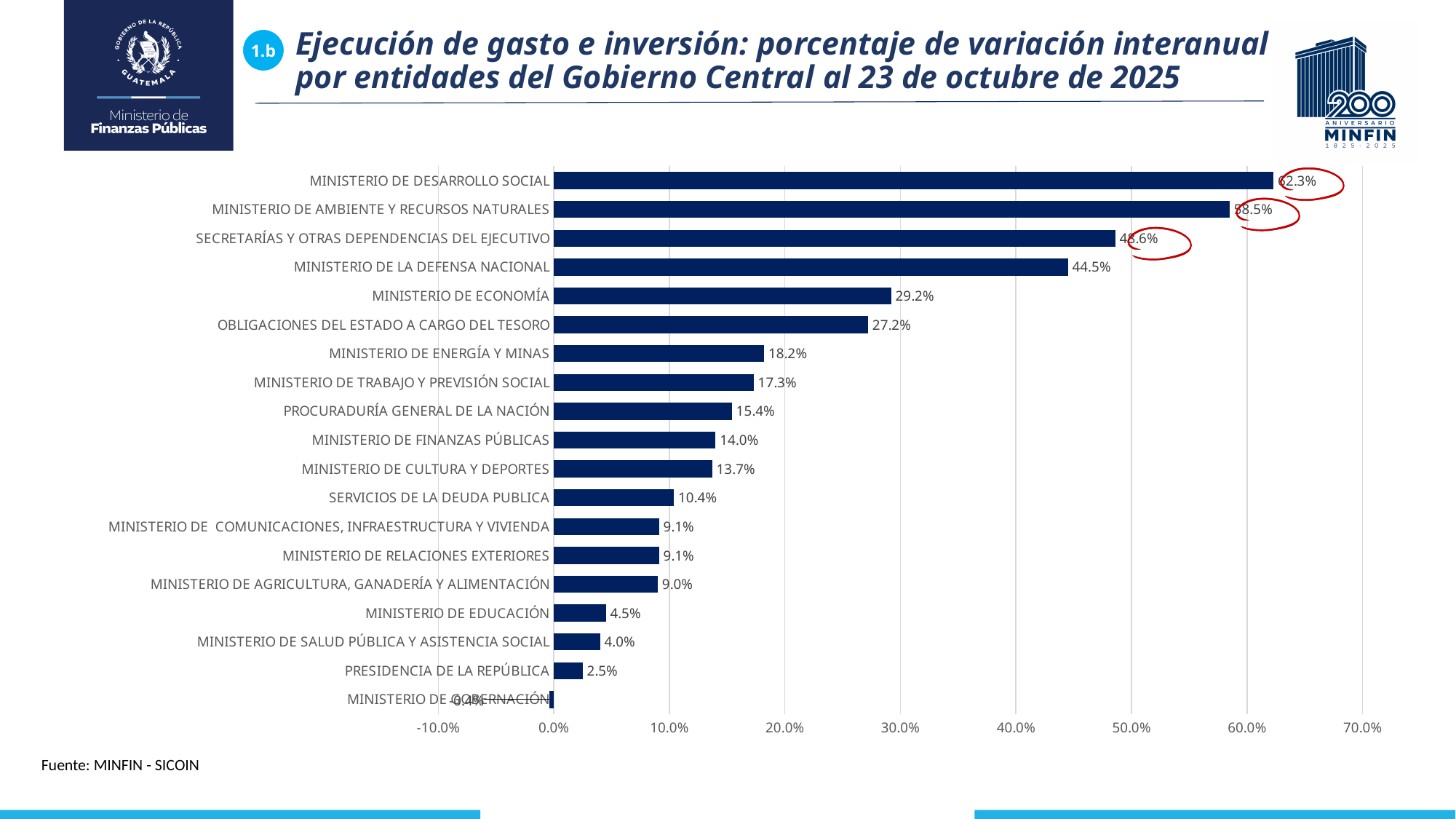
What kind of chart is shown on the slide? bar chart Which is larger, the value for Ministerio de Economía or for Obligaciones del Estado a Cargo del Tesoro? Ministerio de Economía How many entities are shown in the chart? 19 What is the value for Ministerio de Finanzas Públicas? 14.0% Which three entities have their data labels circled in red? Ministerio de Desarrollo Social, Ministerio de Ambiente y Recursos Naturales, Secretarías y Otras Dependencias del Ejecutivo What is the difference between the values for Ministerio de Desarrollo Social and Ministerio de Ambiente y Recursos Naturales? 3.8 percentage points Which entity has the highest percentage of interannual variation? Ministerio de Desarrollo Social What is the value for Ministerio de la Defensa Nacional? 44.5% What is the value for Ministerio de Educación? 4.5% Which entity has the lowest percentage of interannual variation? Ministerio de Gobernación What is the value for Servicios de la Deuda Publica? 10.4% Is the value for Ministerio de la Defensa Nacional greater or less than 40.0%? greater